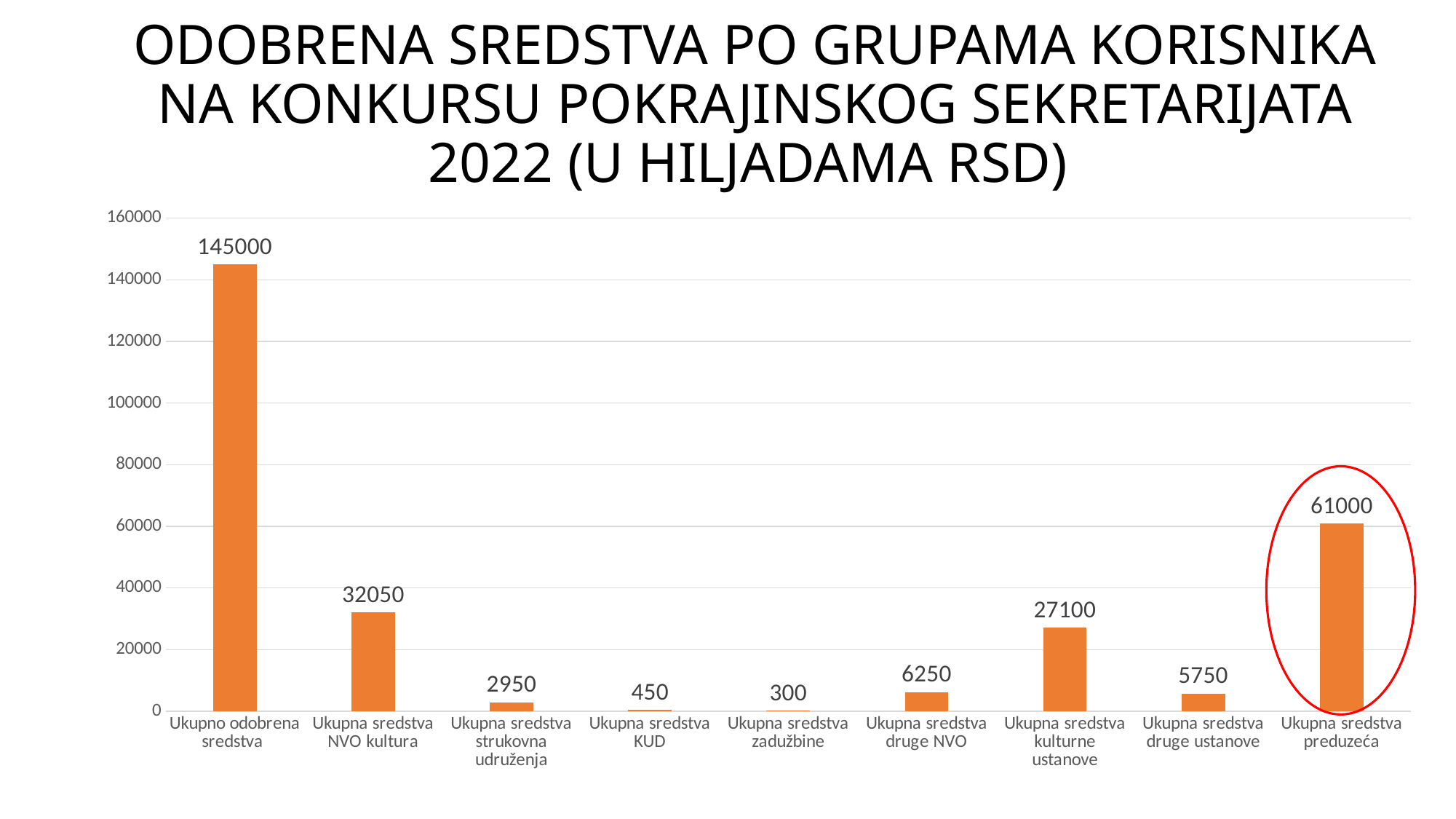
What is the difference between Ukupna sredstva preduzeća and Ukupna sredstva NVO kultura? 28950 What is the value for Ukupna sredstva zadužbine? 300 Which is larger, Ukupna sredstva druge NVO or Ukupna sredstva druge ustanove? Ukupna sredstva druge NVO What kind of chart is shown on the slide? Bar chart What is the value for Ukupna sredstva kulturne ustanove? 27100 Which category has the lowest value? Ukupna sredstva zadužbine Which bar is circled in red on the chart? Ukupna sredstva preduzeća What is the value for Ukupna sredstva preduzeća? 61000 How many categories are shown on the x axis? 9 What is the value for Ukupna sredstva NVO kultura? 32050 Which category has the highest value? Ukupno odobrena sredstva What is the difference between Ukupna sredstva KUD and Ukupna sredstva zadužbine? 150